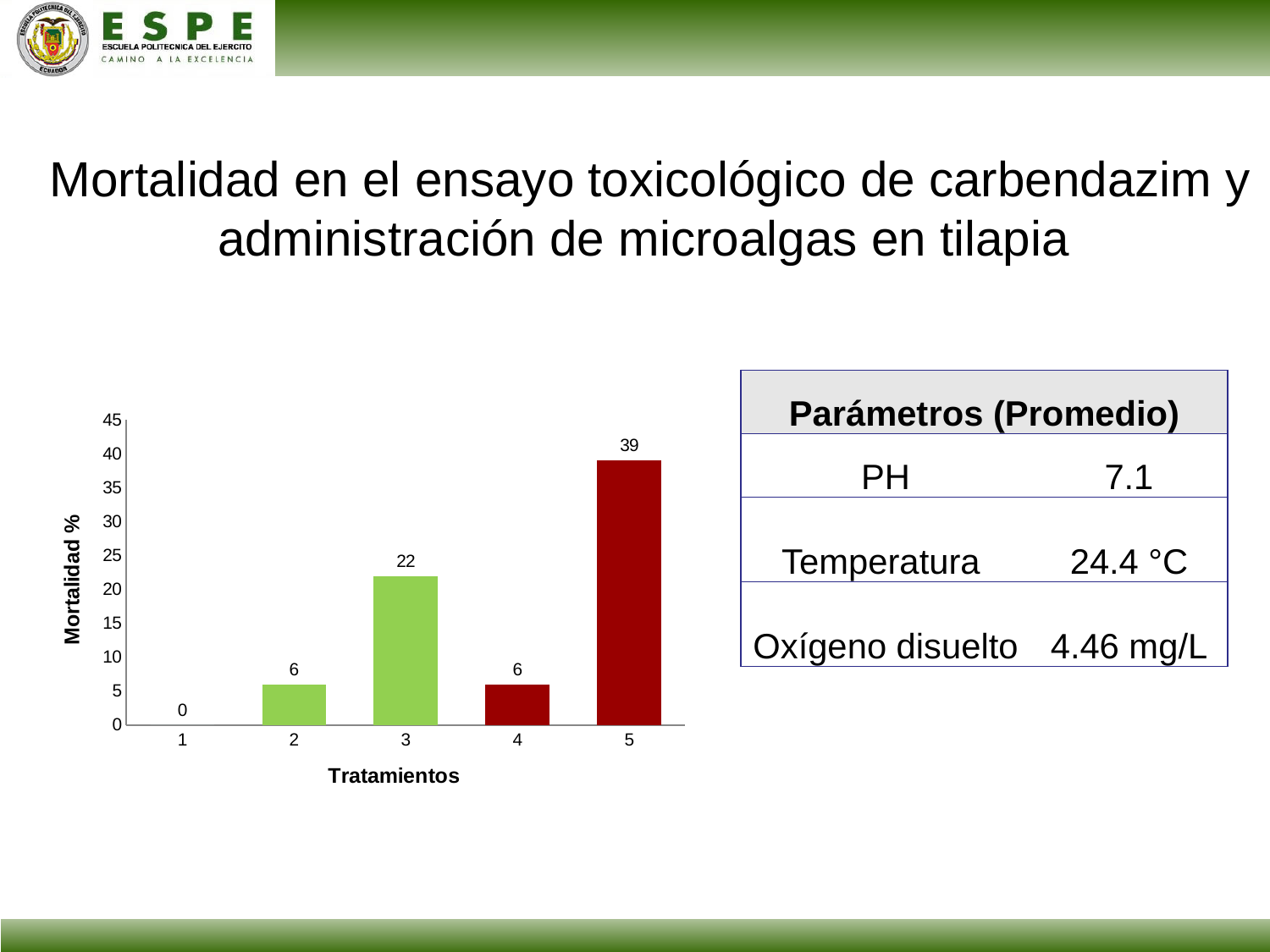
What is the difference in mortality between treatment 5 and treatment 3? 17 Which treatment has the highest mortality? 5 What is the mortality percentage for treatment 3? 22 Is the value for treatment 5 greater or less than 35? greater Which has higher mortality, treatment 2 or treatment 3? Treatment 3 Which treatment has the lowest mortality? 1 What is the label of the x axis? Tratamientos What is the mortality percentage for treatment 1? 0 How many treatments are shown on the x axis? 5 What is the mortality percentage for treatment 5? 39 What is the label of the y axis? Mortalidad % What kind of chart is shown on the slide? Bar chart